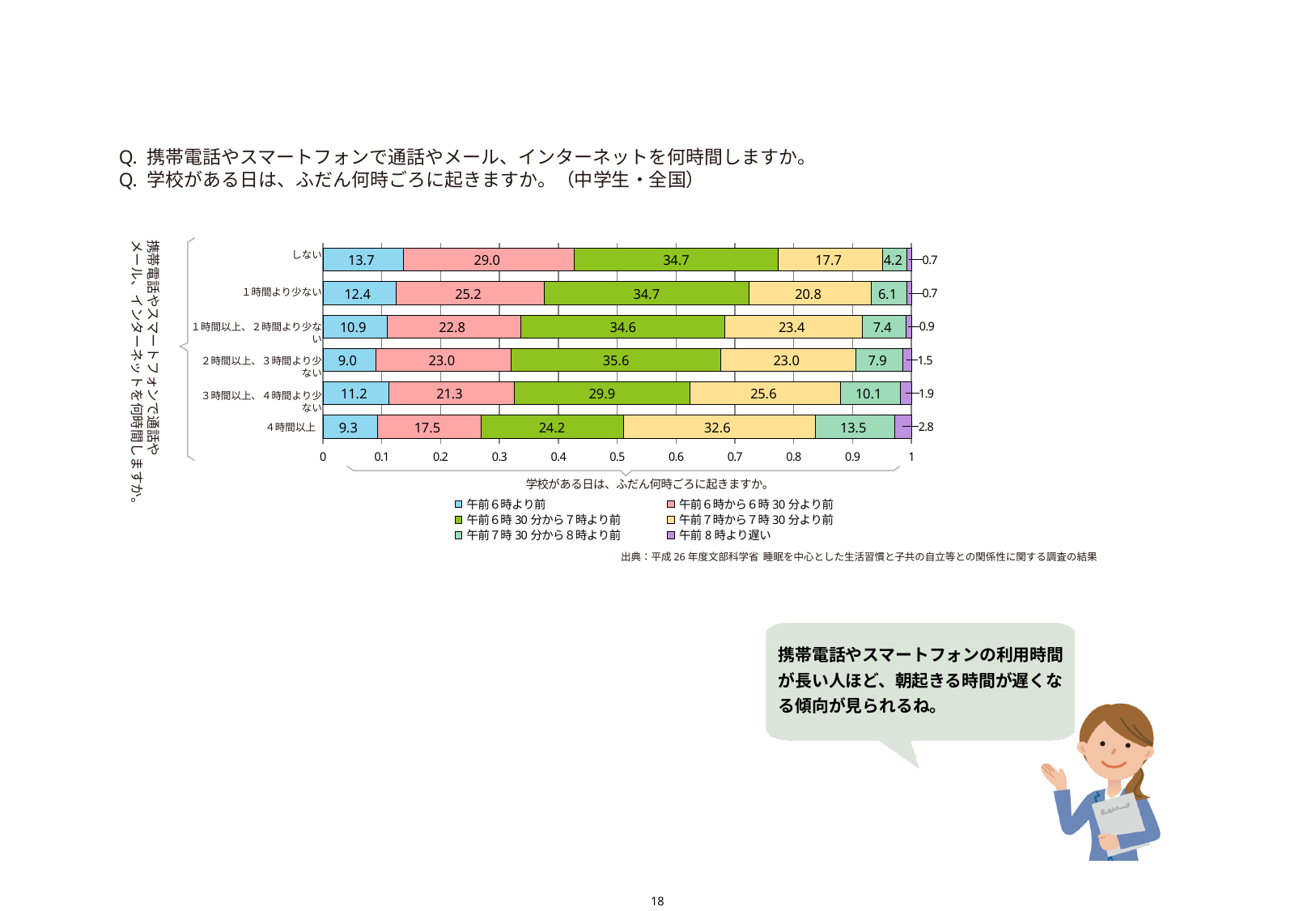
Which is larger: the 午前7時から7時30分より前 value for 1時間より少ない or for 3時間以上、4時間より少ない? 3時間以上、4時間より少ない Which category has the highest value for 午前6時30分から7時より前? 2時間以上、3時間より少ない Which category has the lowest value for 午前7時30分から8時より前? しない What type of chart is shown on the slide? Stacked bar chart What is the difference between the 午前6時から6時30分より前 values for しない and 4時間以上? 11.5 How many categories (phone usage time groups) are shown on the y axis? 6 Does the value of 午前8時より遅い rise or fall as phone usage time increases from しない to 4時間以上? Rises What is the value of 午前7時から7時30分より前 for the 4時間以上 category? 32.6 What is the value of 午前8時より遅い for the 3時間以上、4時間より少ない category? 1.9 What is the value of 午前6時より前 for the しない category? 13.7 Which series is shown in purple in the legend? 午前8時より遅い How many series does the legend list? 6